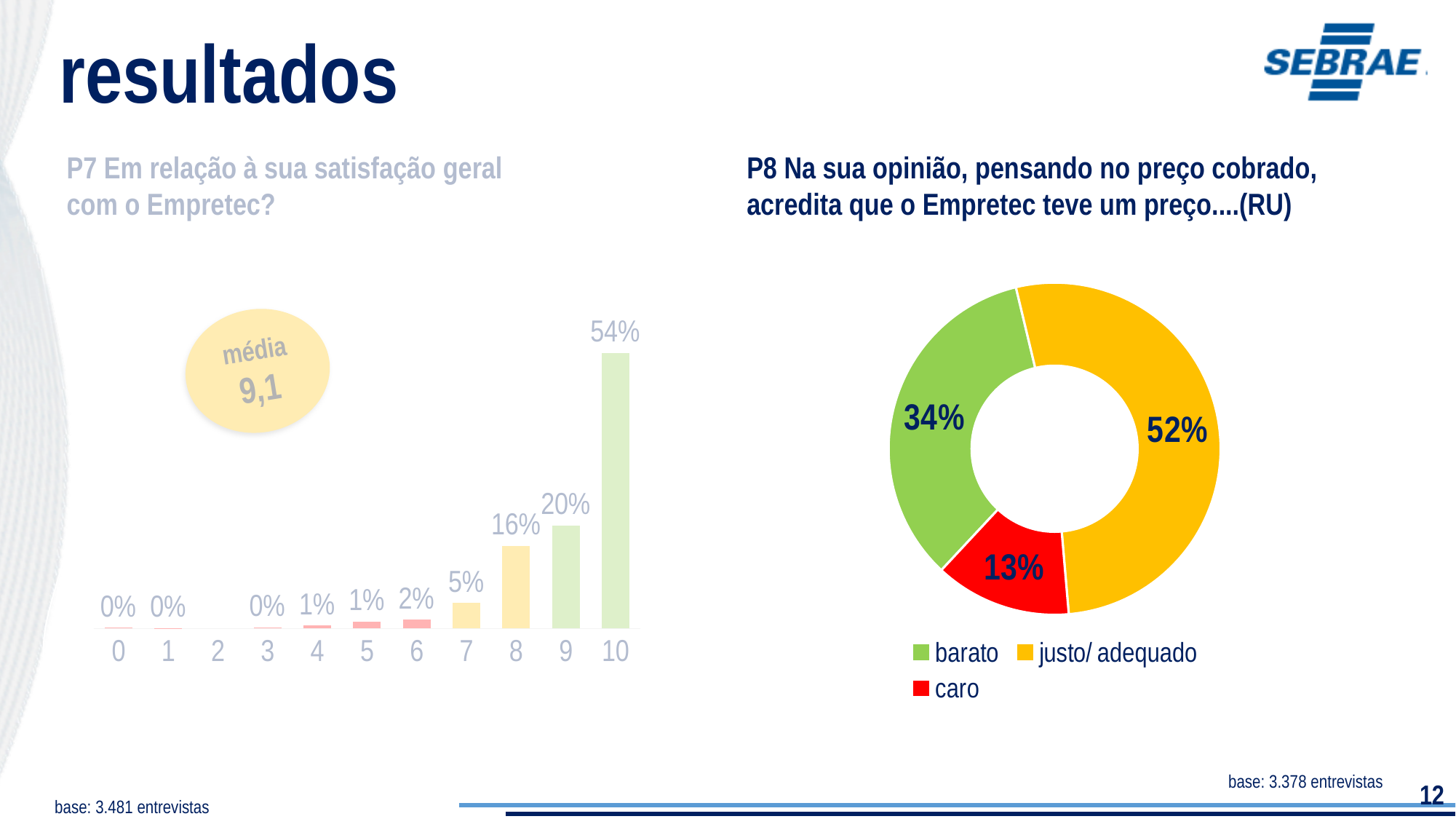
In the left bar chart (P7), which is larger, the percentage for score 9 or for score 8? score 9 In the right chart (P8), what share of respondents answered 'justo/ adequado'? 52% In the left bar chart (P7), how many score categories are shown on the x axis? 11 In the right chart (P8), how many categories does the legend list? 3 In the left bar chart (P7), what percentage of respondents gave a score of 10? 54% In the left bar chart (P7), which score has the highest percentage? 10 In the left bar chart (P7), what is the average (média) shown on the slide? 9,1 In the left bar chart (P7), what is the difference between the percentages for scores 10 and 9? 34% In the right chart (P8), what share of respondents answered 'caro'? 13% In the left bar chart (P7), what percentage of respondents gave a score of 7? 5% In the left bar chart (P7), what percentage of respondents gave a score of 8? 16% In the right chart (P8), which category has the smallest share? caro